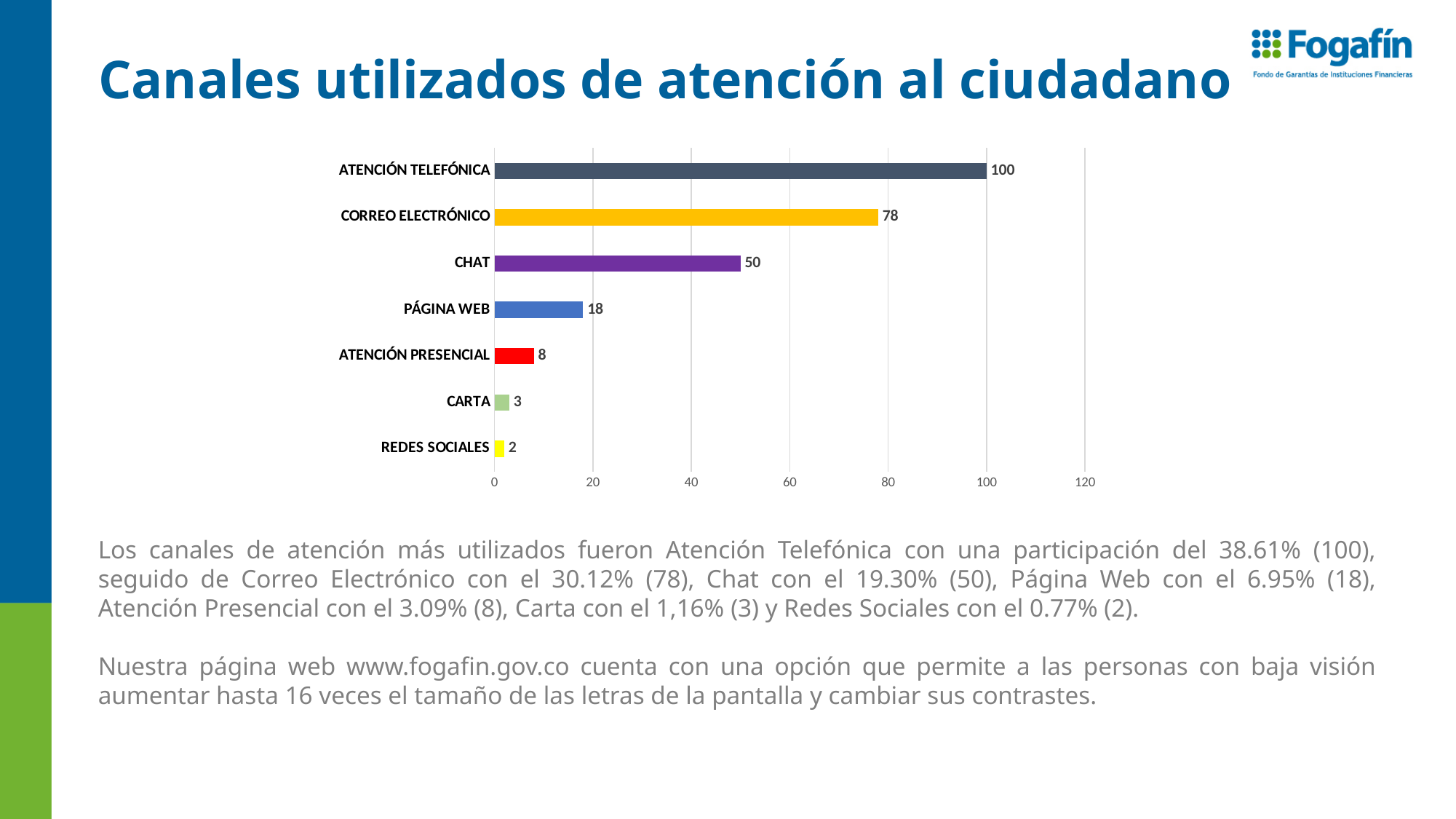
How many categories are shown in the chart? 7 Which category has the lowest value? REDES SOCIALES What is the value for PÁGINA WEB? 18 What is the difference between the values for ATENCIÓN TELEFÓNICA and CORREO ELECTRÓNICO? 22 What is the value for CARTA? 3 What is the difference between the values for CHAT and PÁGINA WEB? 32 What is the value for CORREO ELECTRÓNICO? 78 What is the highest value shown on the horizontal axis? 120 Which category has the highest value? ATENCIÓN TELEFÓNICA What is the value for ATENCIÓN TELEFÓNICA? 100 What kind of chart is shown on the slide? Bar chart Which is larger, the value for CHAT or the value for ATENCIÓN PRESENCIAL? CHAT